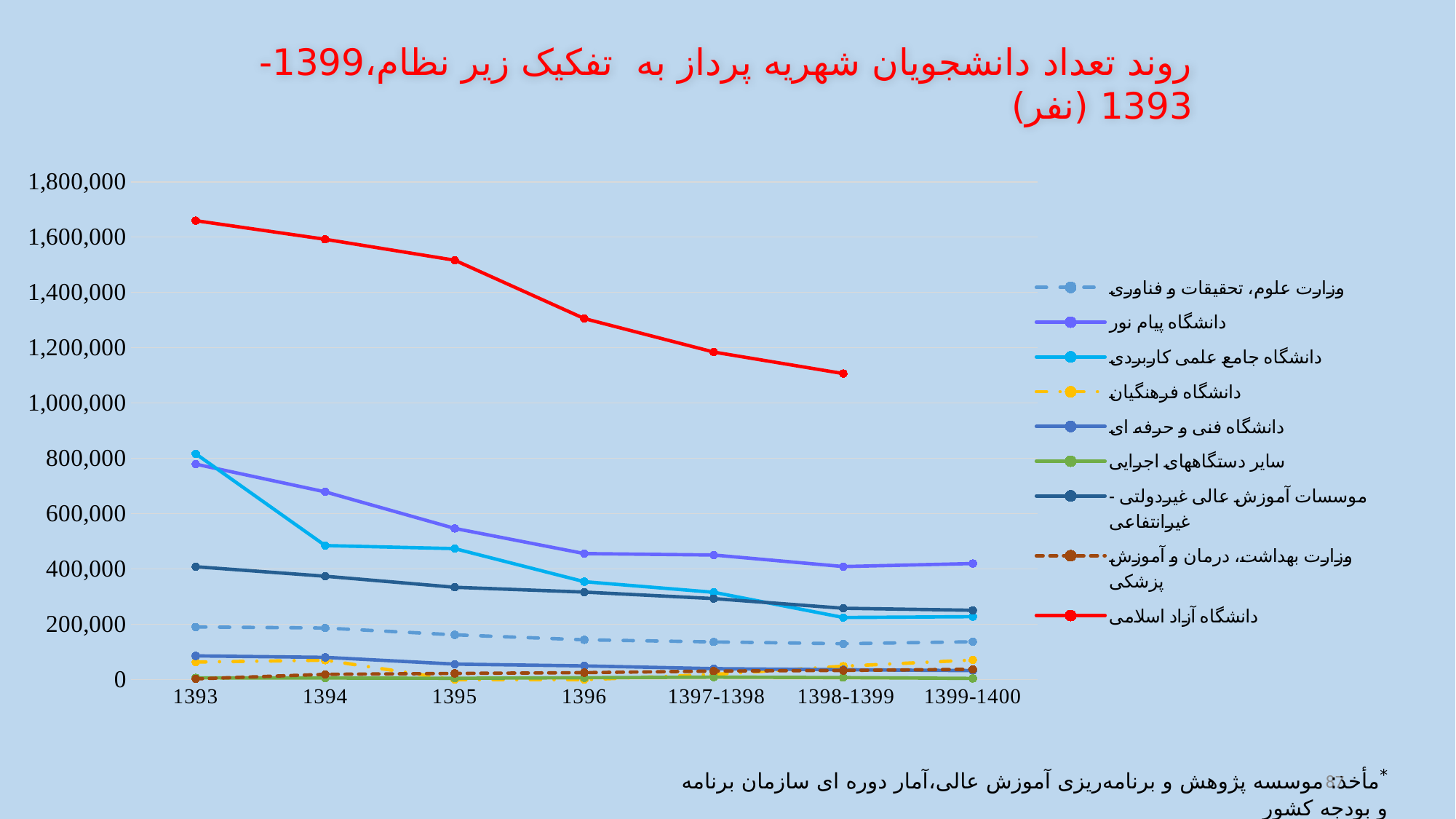
In 1396, which is larger: the value for دانشگاه آزاد اسلامی or the value for دانشگاه پیام نور? دانشگاه آزاد اسلامی In 1394, which is larger: the value for دانشگاه پیام نور or the value for دانشگاه جامع علمی کاربردی? دانشگاه پیام نور Which series has the highest value in 1393? دانشگاه آزاد اسلامی Does the value for دانشگاه آزاد اسلامی rise or fall from 1393 to 1398-1399? fall Is the value for دانشگاه پیام نور in 1393 greater or less than 600,000? greater Is the value for دانشگاه آزاد اسلامی in 1393 greater or less than 1,400,000? greater What kind of chart is shown on the slide? line chart Is the value for دانشگاه آزاد اسلامی in 1398-1399 greater or less than 1,200,000? less How many categories are shown on the x axis? 7 What colour is the line for دانشگاه آزاد اسلامی? red How many series does the legend list? 9